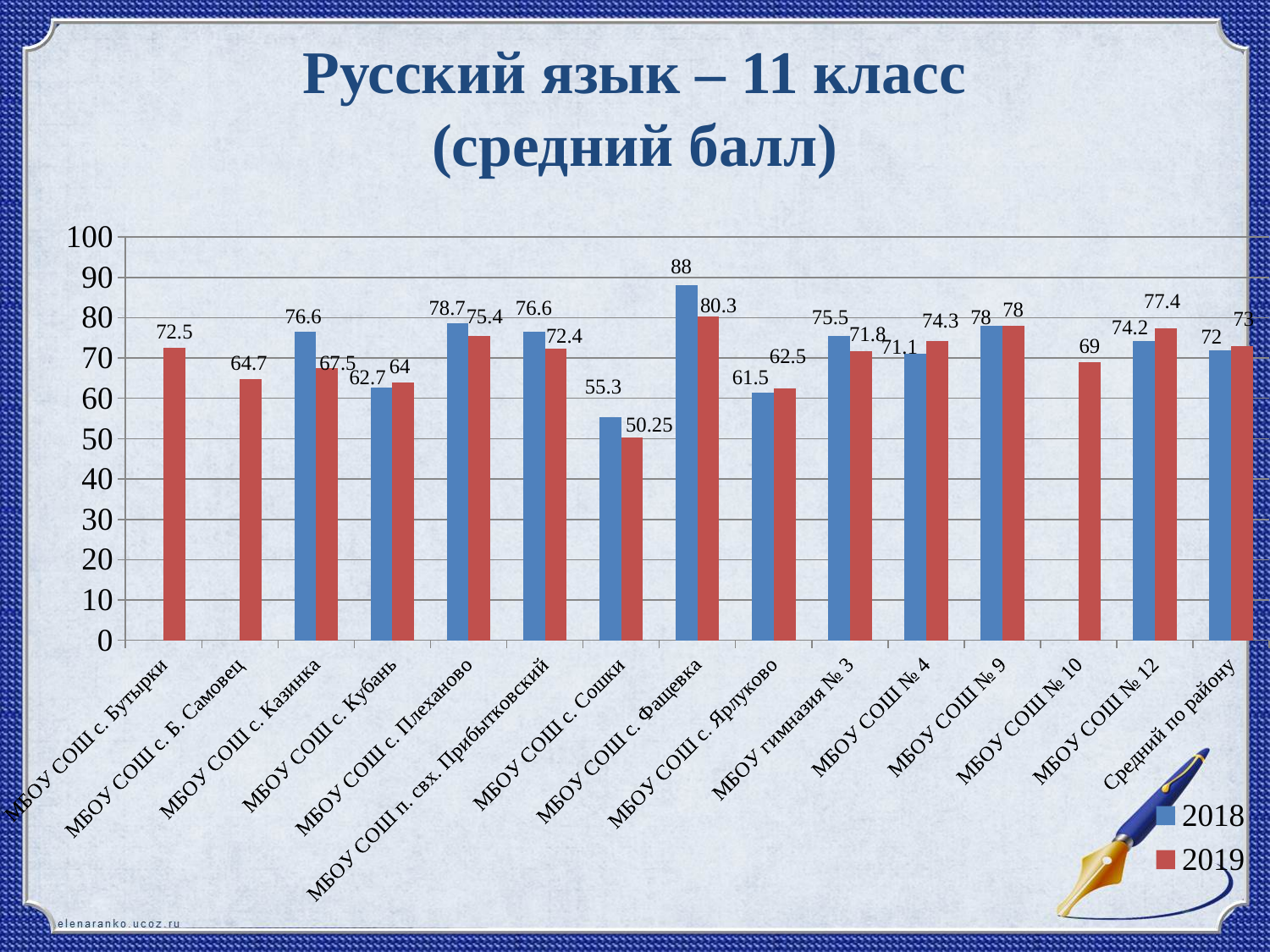
What is the 2019 value for МБОУ СОШ с. Сошки? 50.25 Which is larger for МБОУ СОШ № 4: the 2018 value or the 2019 value? 2019 Which category has the highest 2018 value? МБОУ СОШ с. Фащевка What kind of chart is shown on the slide? Bar chart What is the 2019 value for МБОУ СОШ с. Бутырки? 72.5 What is the 2018 value for МБОУ СОШ с. Фащевка? 88 Which category has the lowest 2019 value? МБОУ СОШ с. Сошки What is the 2018 value for Средний по району? 72 How many series does the legend list? 2 How many categories are shown on the x axis? 15 What is the difference between the 2018 and 2019 values for МБОУ СОШ с. Казинка? 9.1 What is the title of the chart on the slide? Русский язык – 11 класс (средний балл)